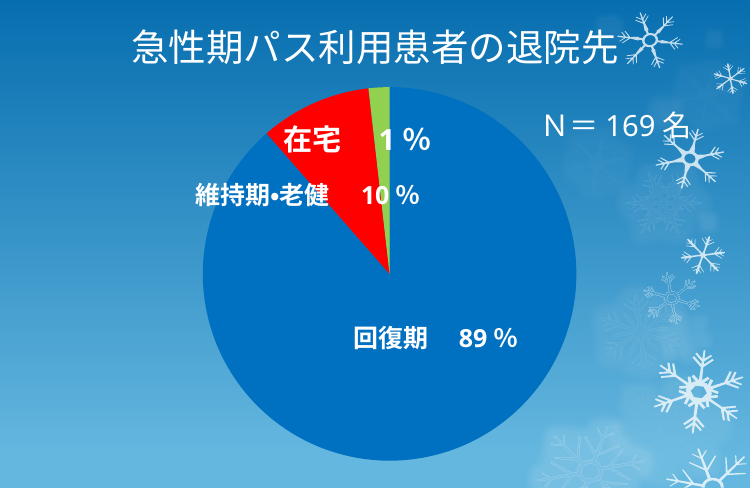
What is the difference in percentage points between 維持期・老健 and 在宅? 9 What percentage of patients were discharged to 回復期? 89 % Which is larger, the share for 維持期・老健 or the share for 在宅? 維持期・老健 What percentage of patients were discharged to 維持期・老健? 10 % Which discharge destination has the largest share of the pie? 回復期 What kind of chart is shown on the slide? pie chart Which discharge destination has the smallest share of the pie? 在宅 What is the title of the chart? 急性期パス利用患者の退院先 What is the total number of patients (N) shown on the slide? 169 名 What is the difference in percentage points between 回復期 and 維持期・老健? 79 How many slices does the pie chart have? 3 What percentage of patients were discharged to 在宅? 1 %